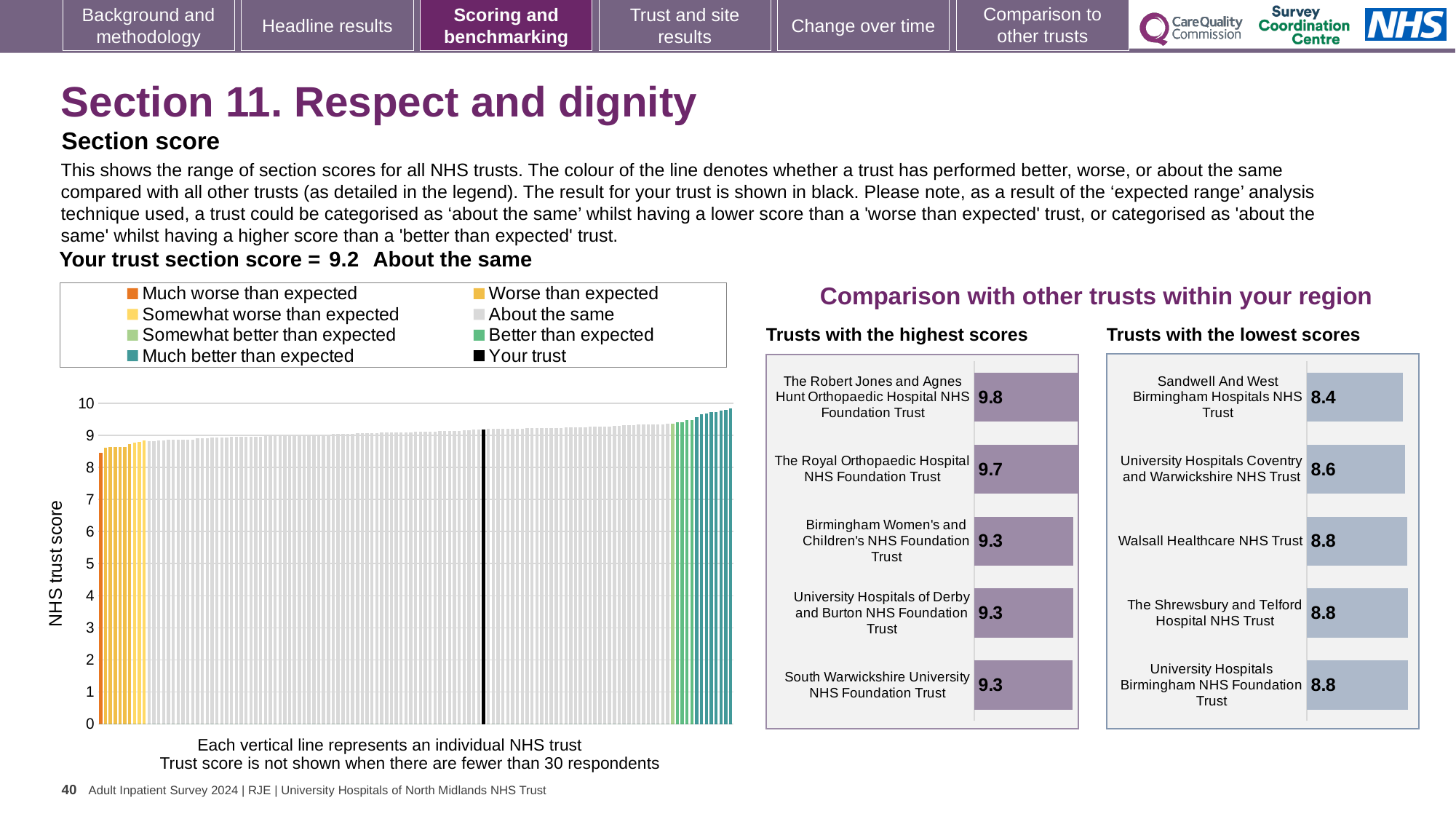
In the 'Trusts with the lowest scores' chart, which trust has the lowest score? Sandwell And West Birmingham Hospitals NHS Trust In the large chart on the left, do the trust scores rise or fall from left to right along the x axis? Rise In the 'Trusts with the highest scores' chart, what is the difference between the scores of The Robert Jones and Agnes Hunt Orthopaedic Hospital NHS Foundation Trust and The Royal Orthopaedic Hospital NHS Foundation Trust? 0.1 In the 'Trusts with the lowest scores' chart, what is the score for Sandwell And West Birmingham Hospitals NHS Trust? 8.4 In the 'Trusts with the highest scores' chart, what is the score for The Robert Jones and Agnes Hunt Orthopaedic Hospital NHS Foundation Trust? 9.8 How many trusts are shown in the 'Trusts with the highest scores' chart? 5 What kind of chart is the large chart on the left showing the range of section scores for all NHS trusts? Bar chart How many entries does the legend of the large chart on the left list? 8 In the 'Trusts with the highest scores' chart, which trust has the highest score? The Robert Jones and Agnes Hunt Orthopaedic Hospital NHS Foundation Trust In the 'Trusts with the highest scores' chart, what is the score for The Royal Orthopaedic Hospital NHS Foundation Trust? 9.7 In the 'Trusts with the lowest scores' chart, which has the larger score: University Hospitals Coventry and Warwickshire NHS Trust or Sandwell And West Birmingham Hospitals NHS Trust? University Hospitals Coventry and Warwickshire NHS Trust In the 'Trusts with the lowest scores' chart, what is the difference between the scores of Walsall Healthcare NHS Trust and Sandwell And West Birmingham Hospitals NHS Trust? 0.4